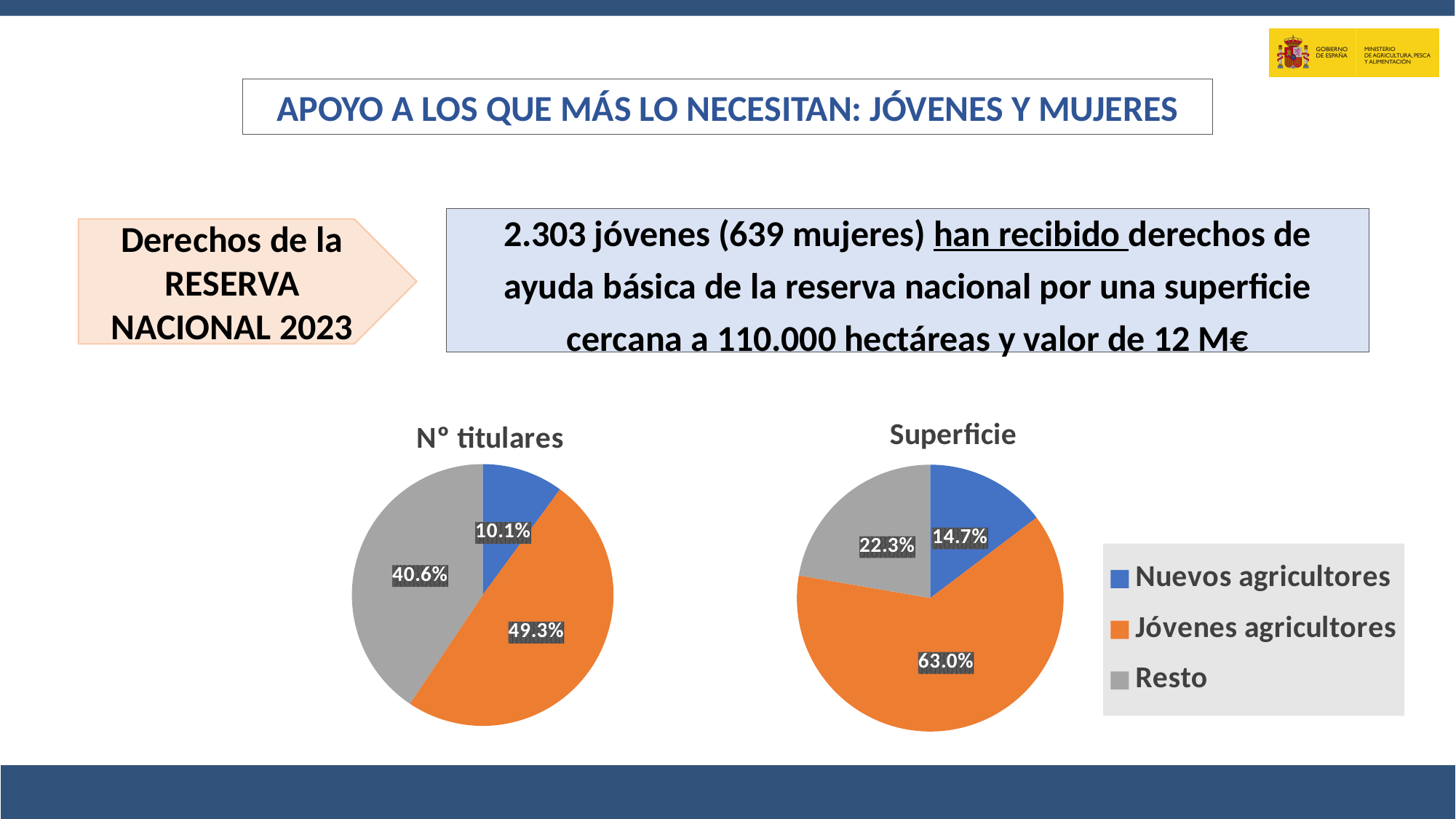
In the 'Nº titulares' pie chart, what share does 'Jóvenes agricultores' have? 49.3% In the 'Nº titulares' pie chart, which category has the smallest slice? Nuevos agricultores In the 'Nº titulares' pie chart, what share does 'Nuevos agricultores' have? 10.1% What type of chart is the 'Superficie' chart? Pie chart In the 'Superficie' pie chart, what share does 'Jóvenes agricultores' have? 63.0% In the 'Superficie' pie chart, which is larger: 'Resto' or 'Nuevos agricultores'? Resto In the 'Nº titulares' pie chart, what is the difference between the 'Jóvenes agricultores' and 'Resto' shares? 8.7% How many categories does the legend list for the pie charts? 3 In the 'Superficie' pie chart, which category has the largest slice? Jóvenes agricultores